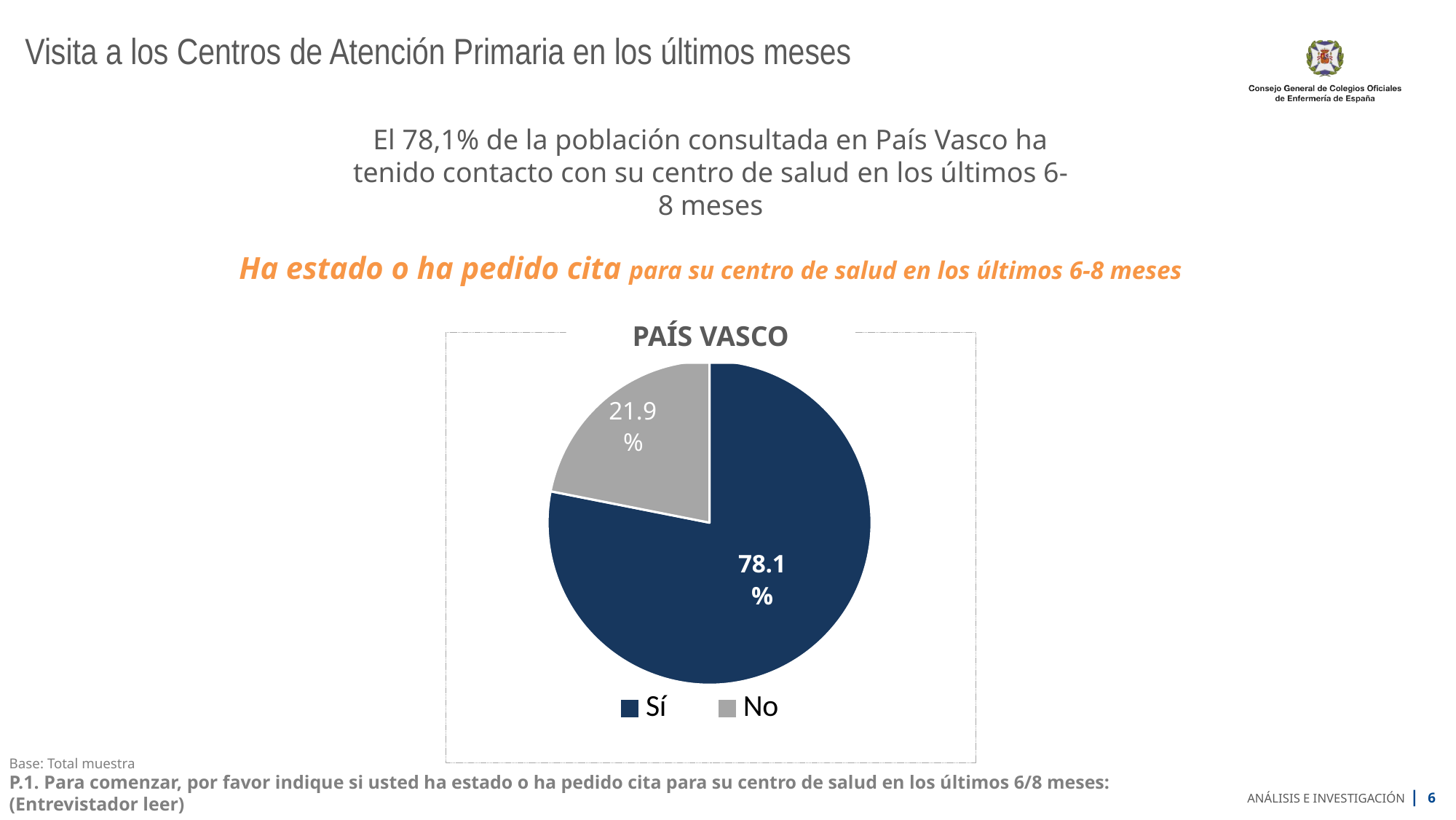
What colour is the "No" slice in the pie chart? Grey Which category has the smallest share of the pie? No What percentage of the pie corresponds to "No"? 21.9% Which category has the largest share of the pie? Sí What is the combined total of the two slices shown in the pie chart? 100% What is the title of the chart? PAÍS VASCO How many slices does the pie chart have? 2 How many entries does the legend list? 2 What is the difference in percentage points between the "Sí" and "No" slices? 56.2 What percentage of the pie corresponds to "Sí"? 78.1% Which slice is larger, "Sí" or "No"? Sí What type of chart is shown on the slide? Pie chart